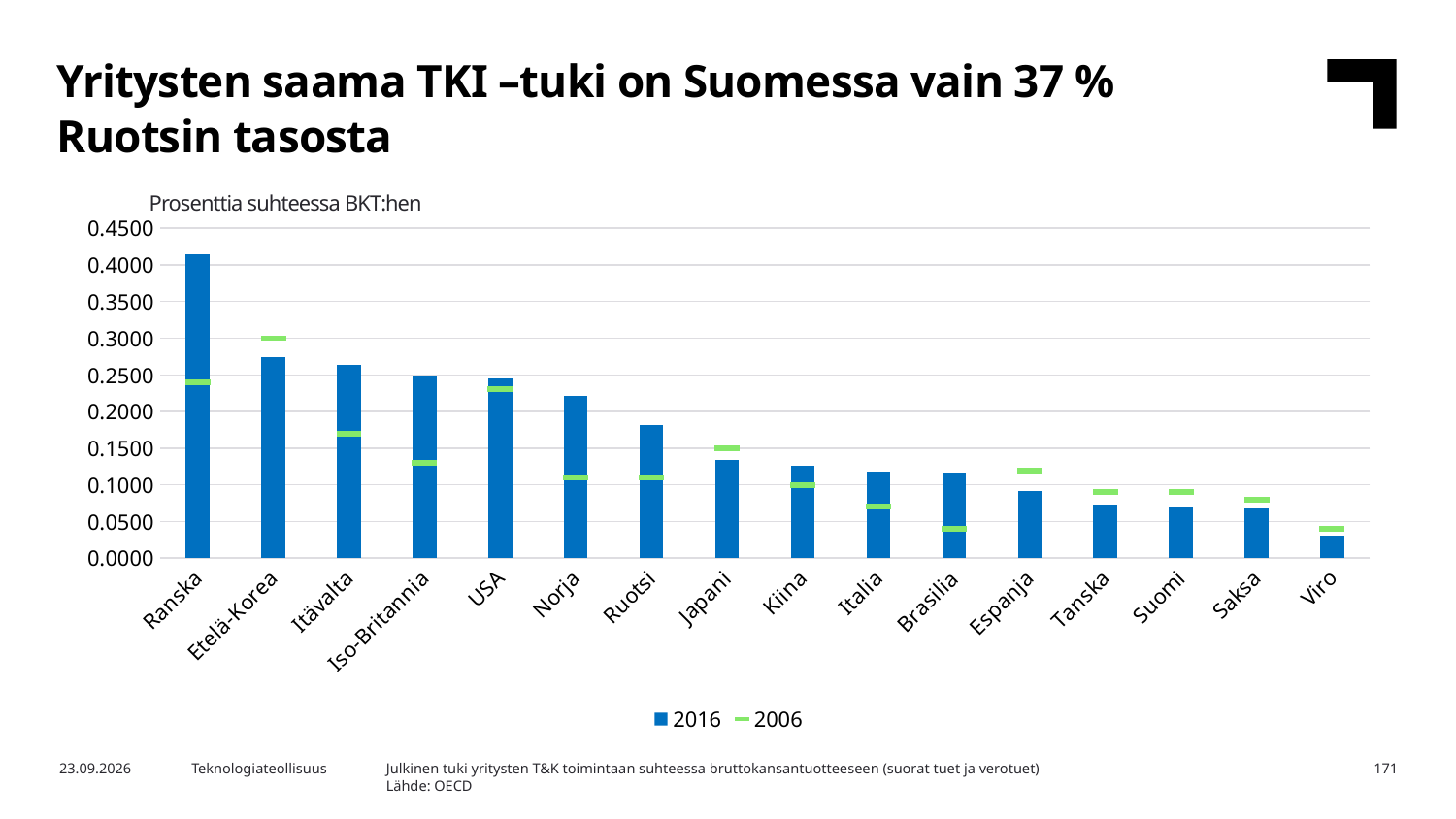
Is the 2016 value for Ruotsi greater or less than 0.2000? less How many series does the chart legend list? 2 What kind of chart is shown on the slide? Bar chart Which has the larger 2016 value, Etelä-Korea or Ruotsi? Etelä-Korea Is the 2016 value for Norja greater or less than 0.2000? greater What are the two series named in the chart legend? 2016 and 2006 Which country has the lowest 2016 value in the chart? Viro Which country has the highest 2016 value in the chart? Ranska Is the 2016 value for Ranska greater or less than 0.4000? greater How many countries are shown on the x axis of the chart? 16 Do the 2016 values rise or fall moving from left to right along the x axis? Fall